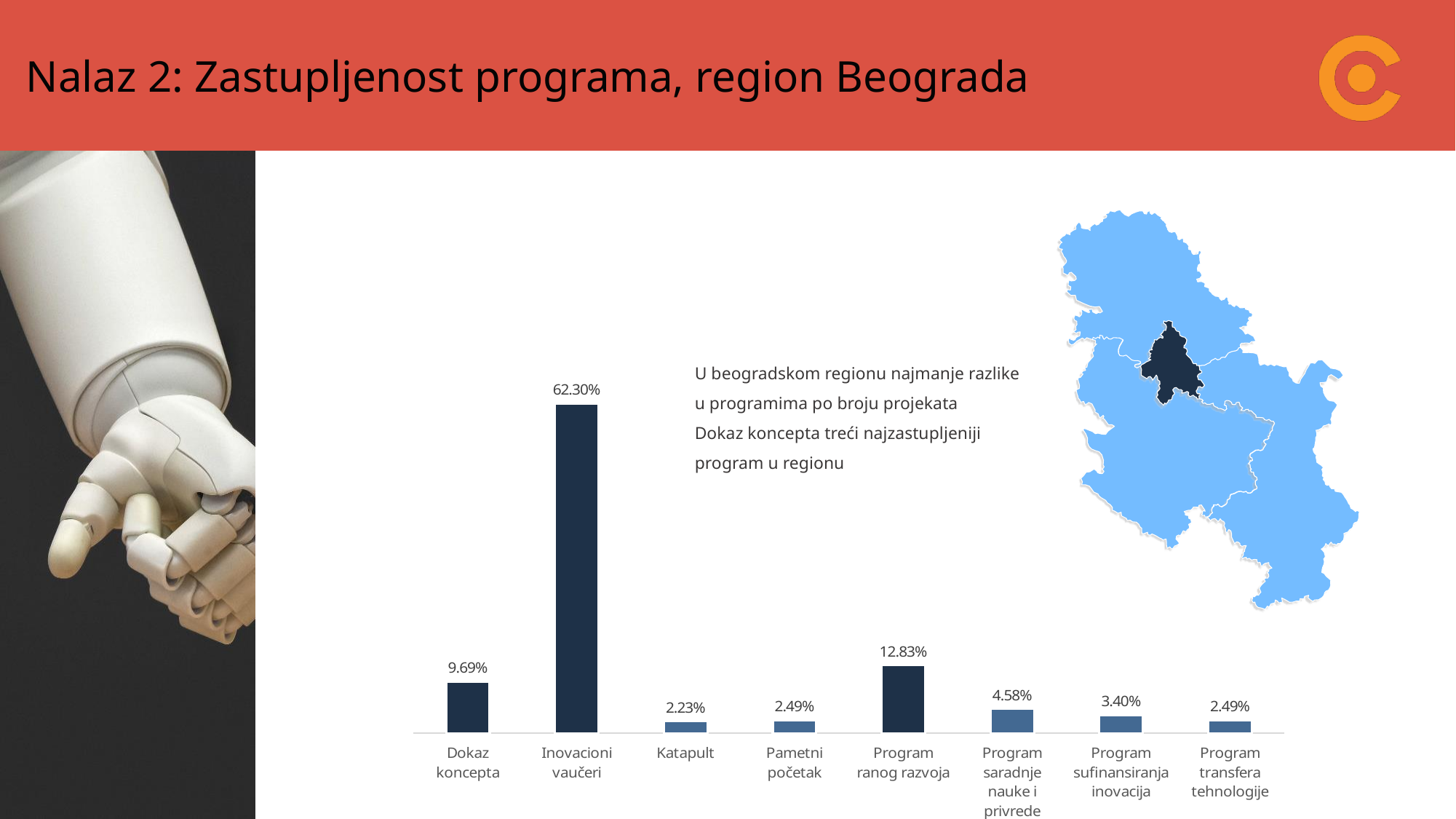
What type of chart is shown on the slide? Bar chart What is the value for Dokaz koncepta? 9.69% What is the value for Program saradnje nauke i privrede? 4.58% Which program has the lowest value in the chart? Katapult What is the value for Program ranog razvoja? 12.83% What is the title of the slide containing the chart? Nalaz 2: Zastupljenost programa, region Beograda What is the difference between the values for Inovacioni vaučeri and Program ranog razvoja? 49.47% Which is larger, the value for Program sufinansiranja inovacija or the value for Program saradnje nauke i privrede? Program saradnje nauke i privrede How many program categories are shown in the chart? 8 What is the difference between the values for Program ranog razvoja and Dokaz koncepta? 3.14% What is the value for Inovacioni vaučeri? 62.30% Which program has the highest value in the chart? Inovacioni vaučeri